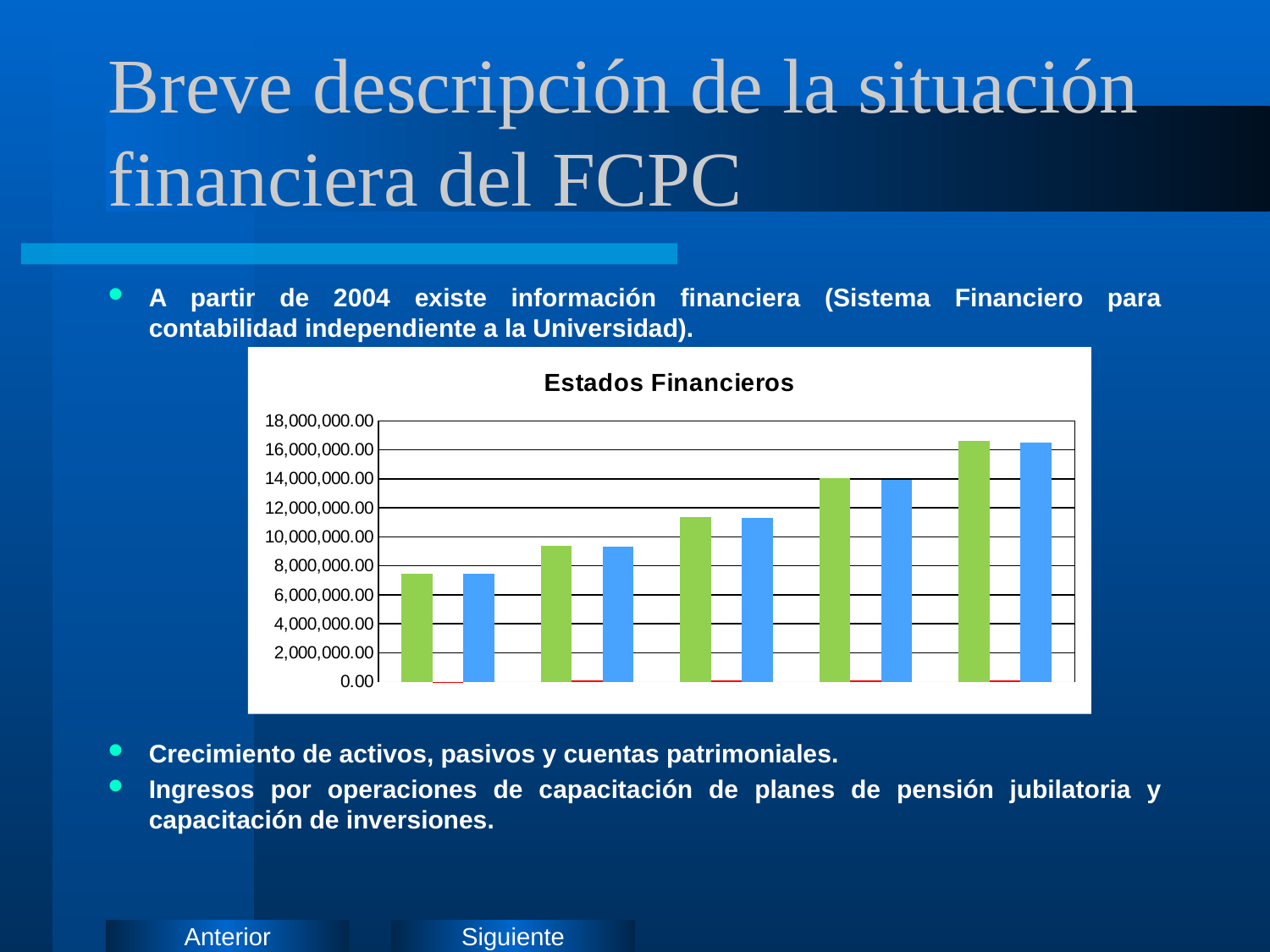
Is the blue bar in the fourth group greater or less than 12,000,000.00? greater Do the green bars rise or fall from left to right across the chart? rise How many groups of bars are plotted in the chart? 5 Which group of bars is the tallest in the chart? the rightmost (fifth) group Which group of bars is the shortest in the chart? the leftmost (first) group Is the green bar in the rightmost group greater or less than 16,000,000.00? greater Is the blue bar in the third group greater or less than 10,000,000.00? greater What kind of chart is shown on the slide? bar chart What is the title of the chart? Estados Financieros Which is larger: the green bar in the second group or the green bar in the fourth group? the green bar in the fourth group What is the highest value shown on the vertical axis of the chart? 18,000,000.00